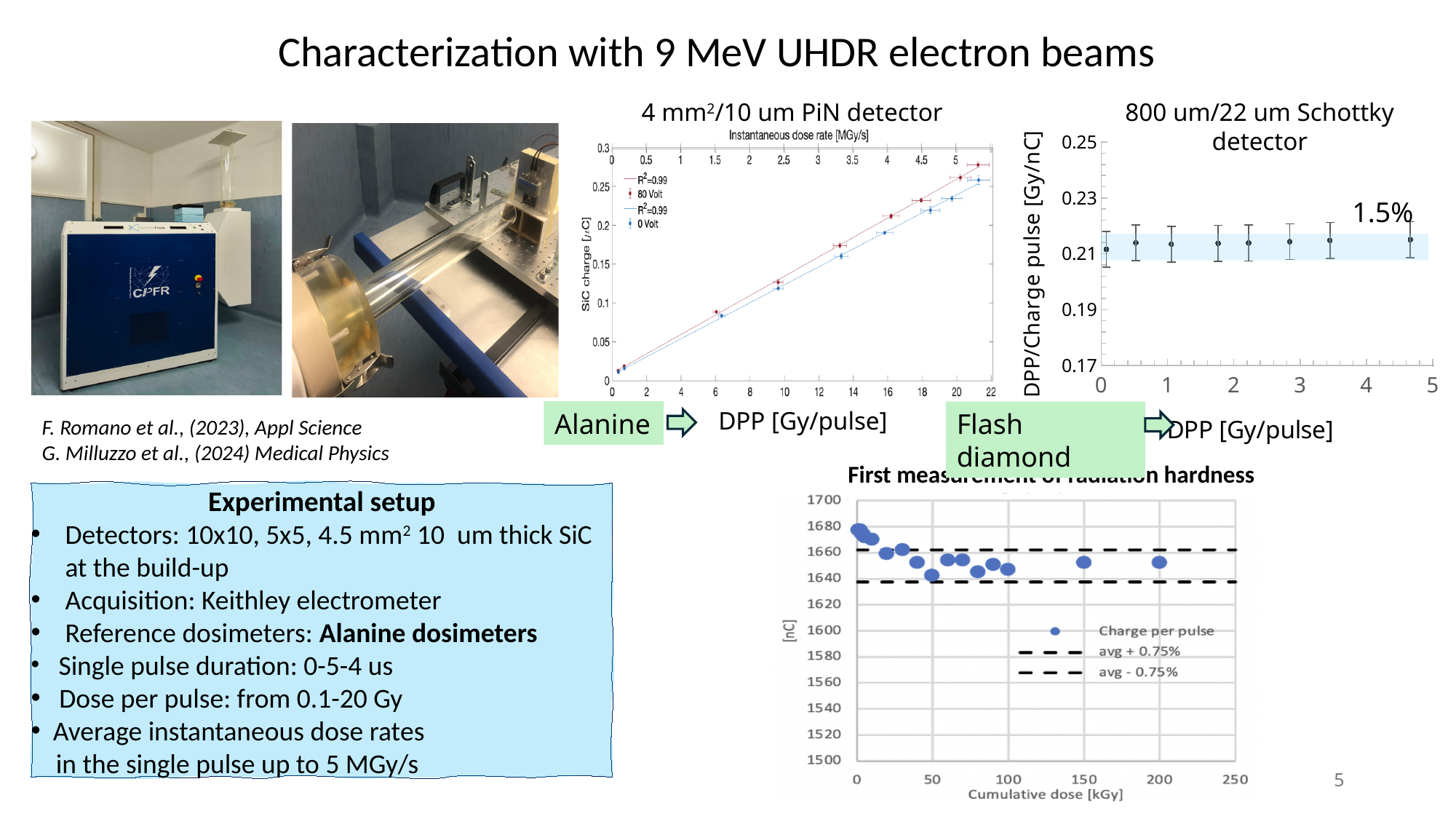
In the '4 mm²/10 um PiN detector' chart, is the SiC charge for the 80 Volt series at the highest DPP greater or less than 0.25? greater In the '4 mm²/10 um PiN detector' chart, does the SiC charge rise or fall as DPP increases? rise In the 'First measurement of radiation hardness' chart, how many entries does the legend list? 3 In the '4 mm²/10 um PiN detector' chart, what R² value is given for the fitted lines? R²=0.99 In the 'First measurement of radiation hardness' chart, which is larger, the charge per pulse at 0 kGy or at 200 kGy? 0 kGy In the '800 um/22 um Schottky detector' chart, what percentage is annotated next to the shaded band? 1.5% In the '800 um/22 um Schottky detector' chart, do the values rise, fall, or stay roughly constant as DPP increases? stay roughly constant In the '800 um/22 um Schottky detector' chart, what is the y-axis label? DPP/Charge pulse [Gy/nC] In the '4 mm²/10 um PiN detector' chart, at the highest DPP, which series has the larger SiC charge, 80 Volt or 0 Volt? 80 Volt In the 'First measurement of radiation hardness' chart, is the charge per pulse at 200 kGy cumulative dose greater or less than 1660? less In the '800 um/22 um Schottky detector' chart, is the value at DPP 1 Gy/pulse greater or less than 0.19? greater In the '4 mm²/10 um PiN detector' chart, what two bias voltages are listed in the legend? 80 Volt and 0 Volt